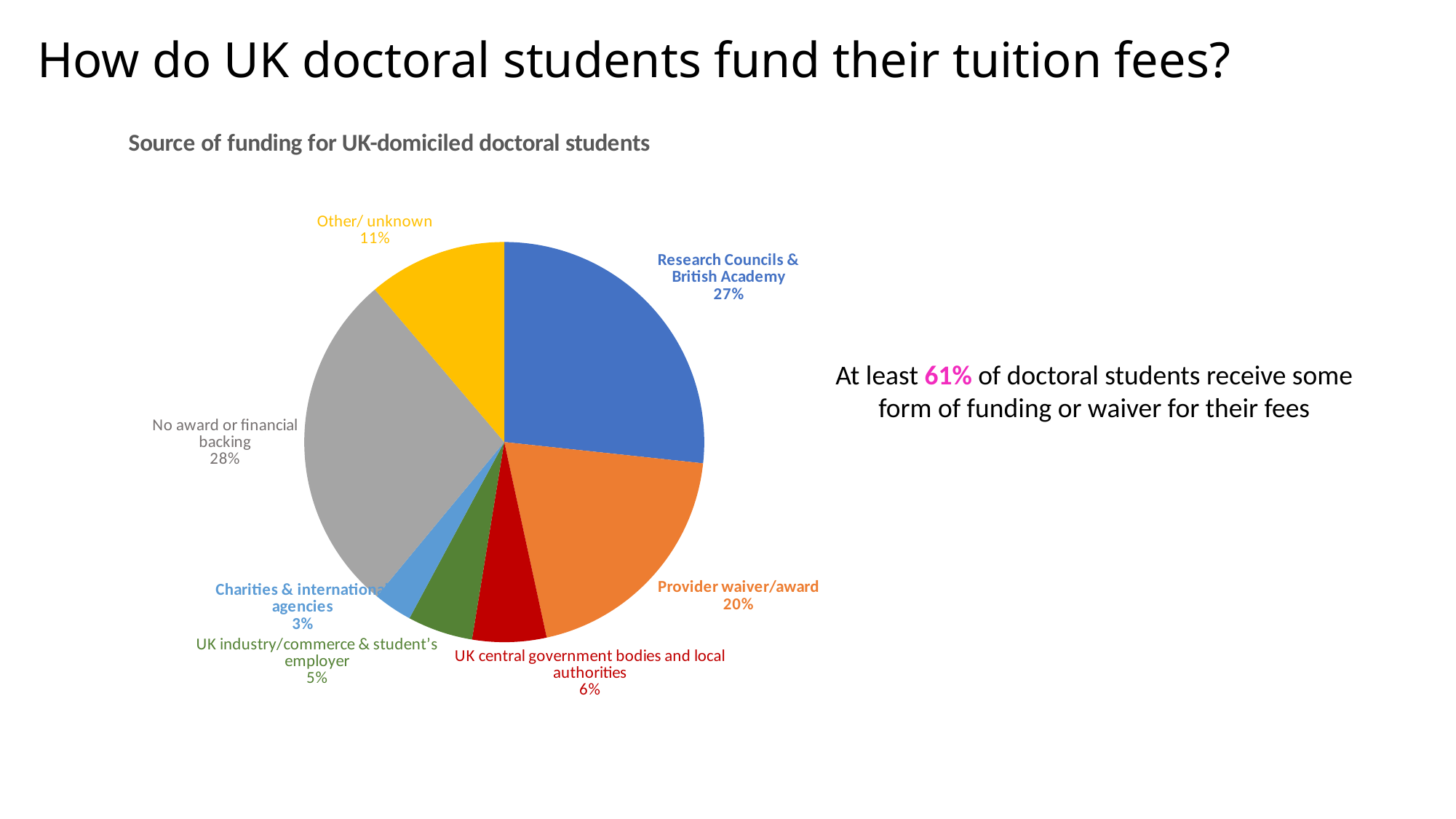
What is the difference between the Research Councils & British Academy share and the Provider waiver/award share? 7% What percentage is shown for Charities & international agencies? 3% What is the title of the chart? Source of funding for UK-domiciled doctoral students What kind of chart is shown on the slide? Pie chart What percentage is shown for Other/ unknown? 11% Which category has the largest share of the pie? No award or financial backing Which category has the smallest share of the pie? Charities & international agencies What percentage is shown for No award or financial backing? 28% What share of the pie is Provider waiver/award? 20% What share of the pie is Research Councils & British Academy? 27% How many categories are shown in the pie chart? 7 Which is larger: UK central government bodies and local authorities or UK industry/commerce & student's employer? UK central government bodies and local authorities